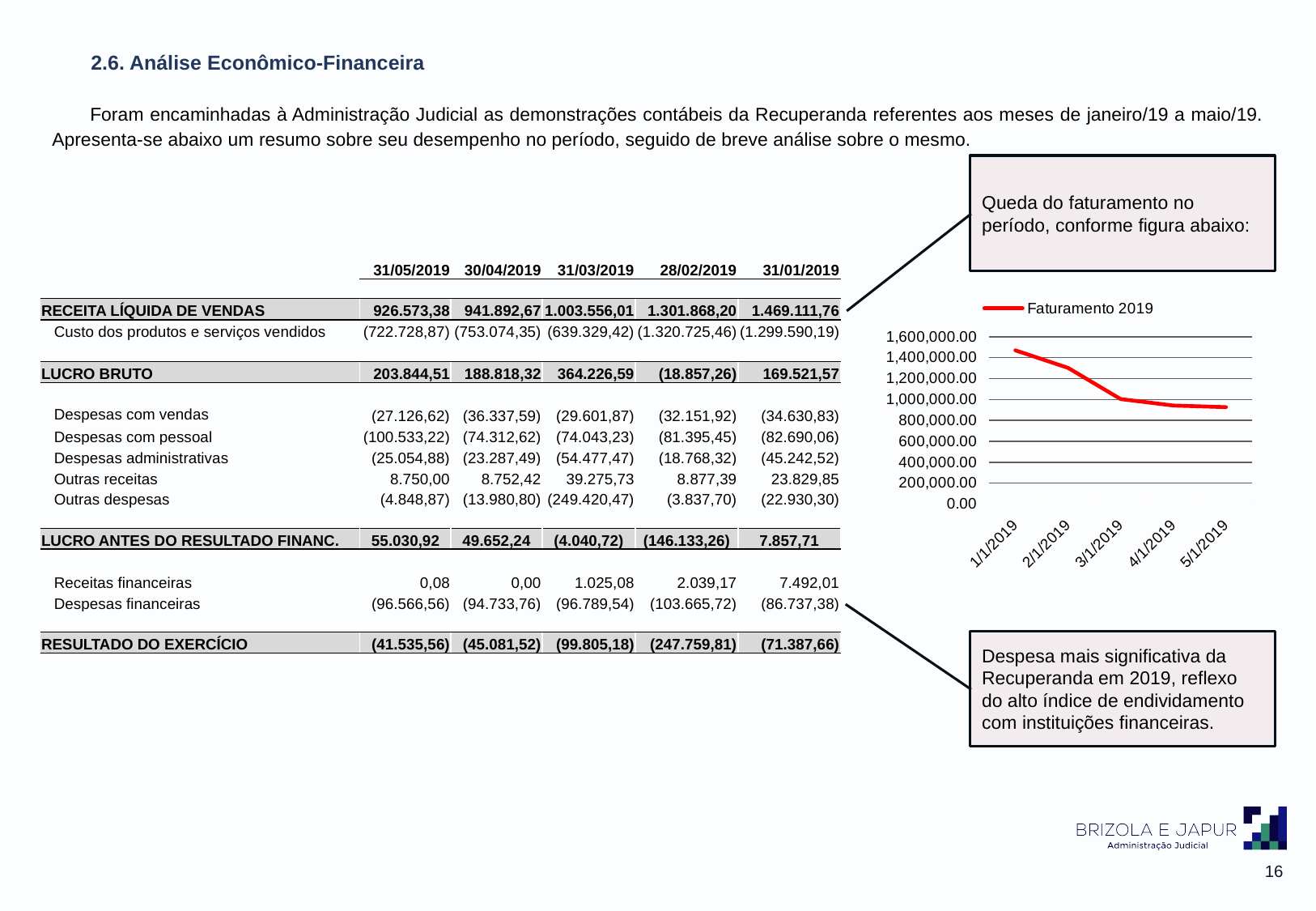
Which date has the highest value in the chart? 1/1/2019 What kind of chart is shown on the slide? line chart Which is larger in the chart, the value for 1/1/2019 or the value for 5/1/2019? 1/1/2019 Is the value for 3/1/2019 greater or less than 1,200,000.00? less Is the value for 2/1/2019 greater or less than 1,200,000.00? greater Is the value for 1/1/2019 greater or less than 1,400,000.00? greater How many dates are shown on the x axis of the chart? 5 Do the values in the chart rise or fall from 1/1/2019 to 5/1/2019? fall How many series does the chart legend list? 1 What is the title of the chart's series shown in the legend? Faturamento 2019 What colour is the line in the chart? red